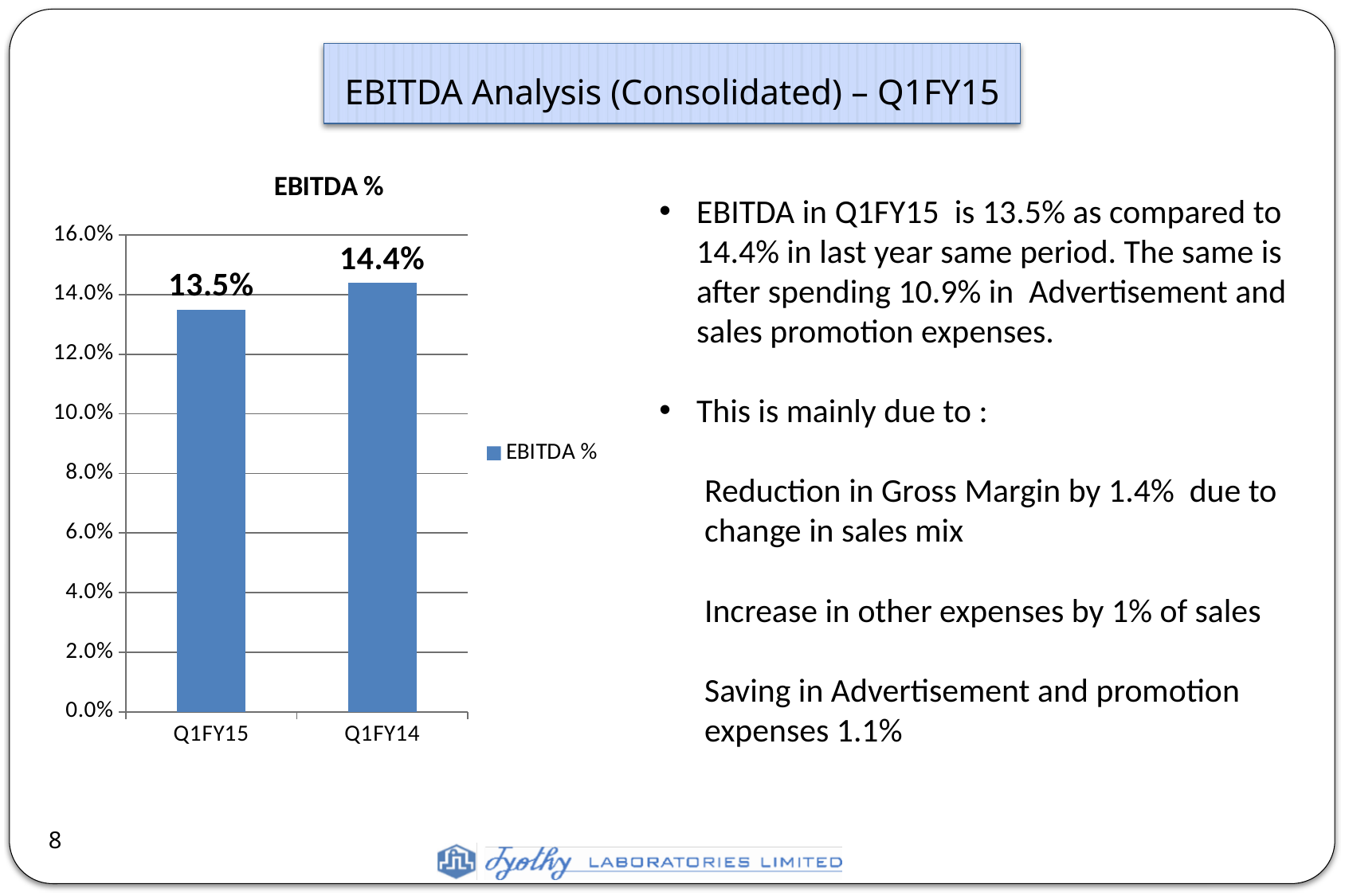
Which period has the lower EBITDA %? Q1FY15 What is the difference between the EBITDA % for Q1FY14 and Q1FY15? 0.9% What is the EBITDA % value for Q1FY15? 13.5% What kind of chart is shown on the slide? bar chart Is the EBITDA % for Q1FY15 larger or smaller than that for Q1FY14? smaller How many periods are shown on the x axis of the chart? 2 Is the EBITDA % for Q1FY15 greater or less than 14.0%? less Is the EBITDA % for Q1FY14 greater or less than 14.0%? greater Which period has the higher EBITDA %? Q1FY14 What is the EBITDA % value for Q1FY14? 14.4% What is the title of the chart? EBITDA % How many series does the chart legend list? 1